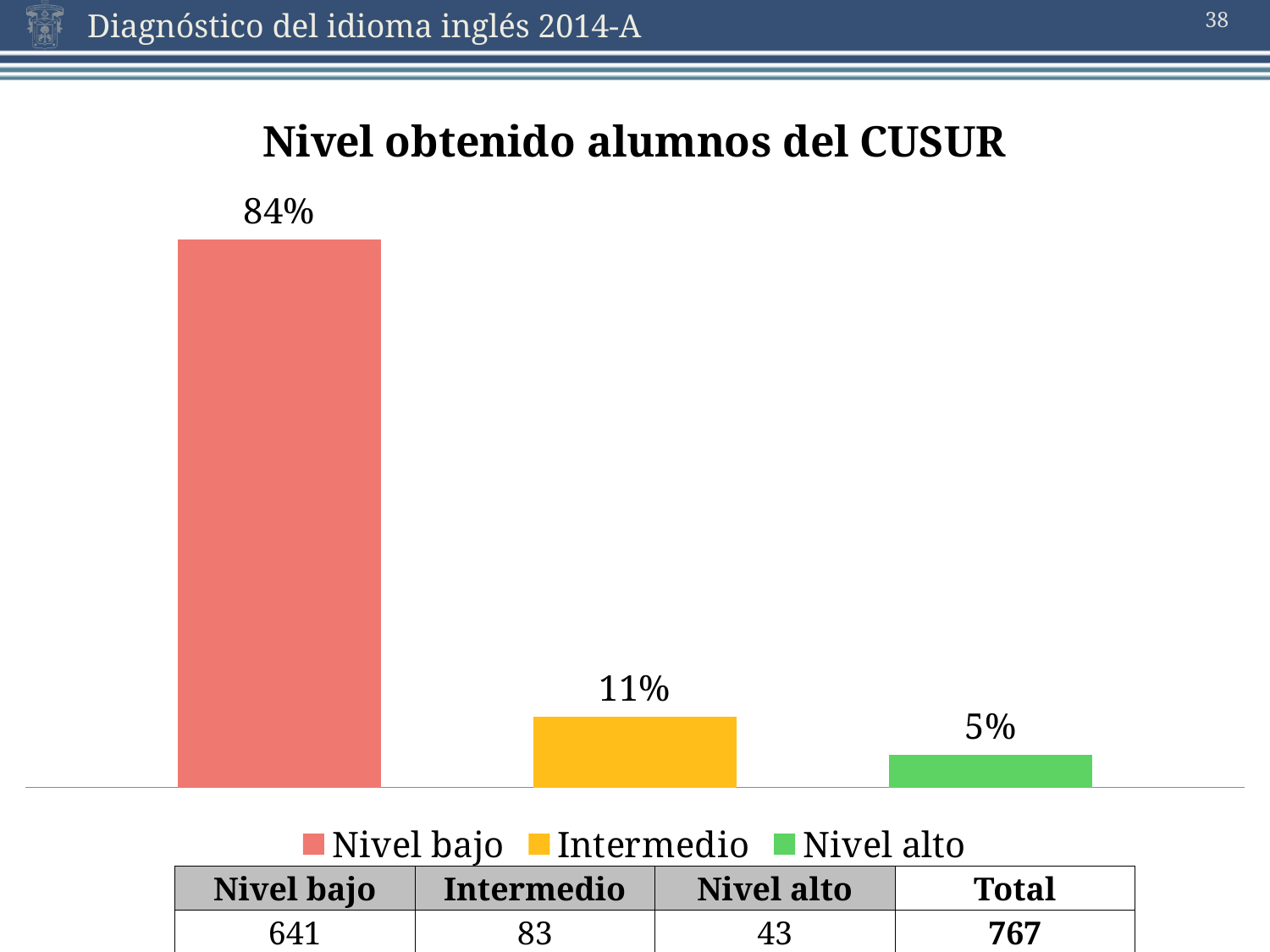
Which category has the lowest value in the chart? Nivel alto What is the title of the chart? Nivel obtenido alumnos del CUSUR What is the difference between the values for Intermedio and Nivel alto? 6% What is the value shown for Nivel bajo in the chart? 84% What is the value shown for Intermedio in the chart? 11% What is the value shown for Nivel alto in the chart? 5% How many bars are plotted in the chart? 3 What is the difference between the values for Nivel bajo and Intermedio? 73% Which is larger, the value for Intermedio or the value for Nivel alto? Intermedio What kind of chart is shown on the slide? Bar chart How many entries does the legend list? 3 Which category has the highest value in the chart? Nivel bajo